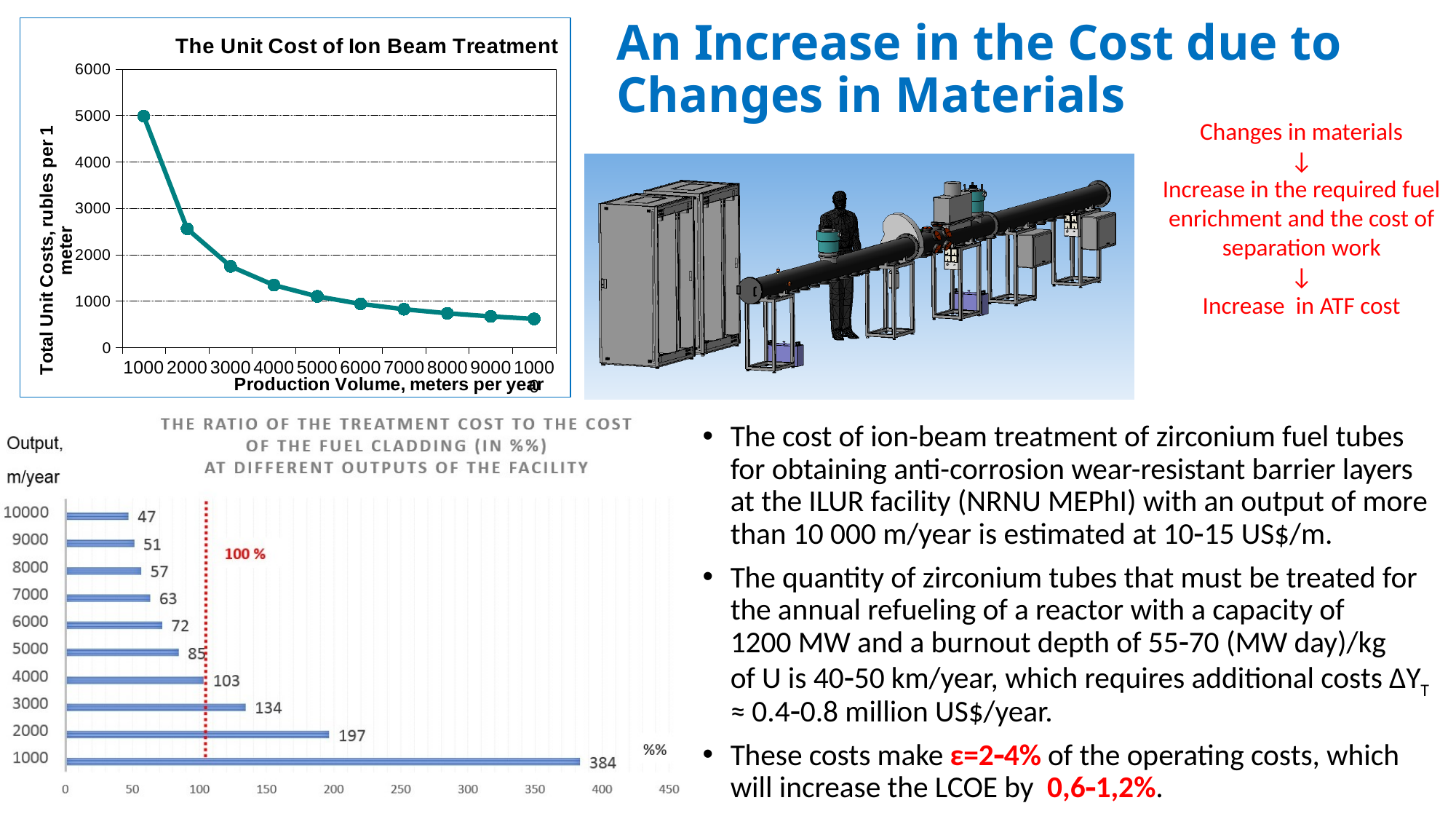
In the bar chart 'The ratio of the treatment cost to the cost of the fuel cladding', what is the difference between the values for 2000 and 3000 m/year? 63 In the bar chart 'The ratio of the treatment cost to the cost of the fuel cladding', what is the value for an output of 5000 m/year? 85 How many output categories are shown in the bar chart 'The ratio of the treatment cost to the cost of the fuel cladding'? 10 In the chart 'The Unit Cost of Ion Beam Treatment', do the total unit costs rise or fall as production volume increases? Fall In the bar chart 'The ratio of the treatment cost to the cost of the fuel cladding', which is larger: the value for 4000 or for 6000 m/year? 4000 In the bar chart 'The ratio of the treatment cost to the cost of the fuel cladding', which output has the highest ratio? 1000 In the chart 'The Unit Cost of Ion Beam Treatment', is the value at a production volume of 2000 greater or less than 3000 rubles per meter? less What kind of chart is 'The ratio of the treatment cost to the cost of the fuel cladding'? Bar chart In the bar chart 'The ratio of the treatment cost to the cost of the fuel cladding', which output has the lowest ratio? 10000 What kind of chart is 'The Unit Cost of Ion Beam Treatment'? Line chart In the bar chart 'The ratio of the treatment cost to the cost of the fuel cladding', what is the value for an output of 10000 m/year? 47 In the bar chart 'The ratio of the treatment cost to the cost of the fuel cladding', what is the value for an output of 1000 m/year? 384